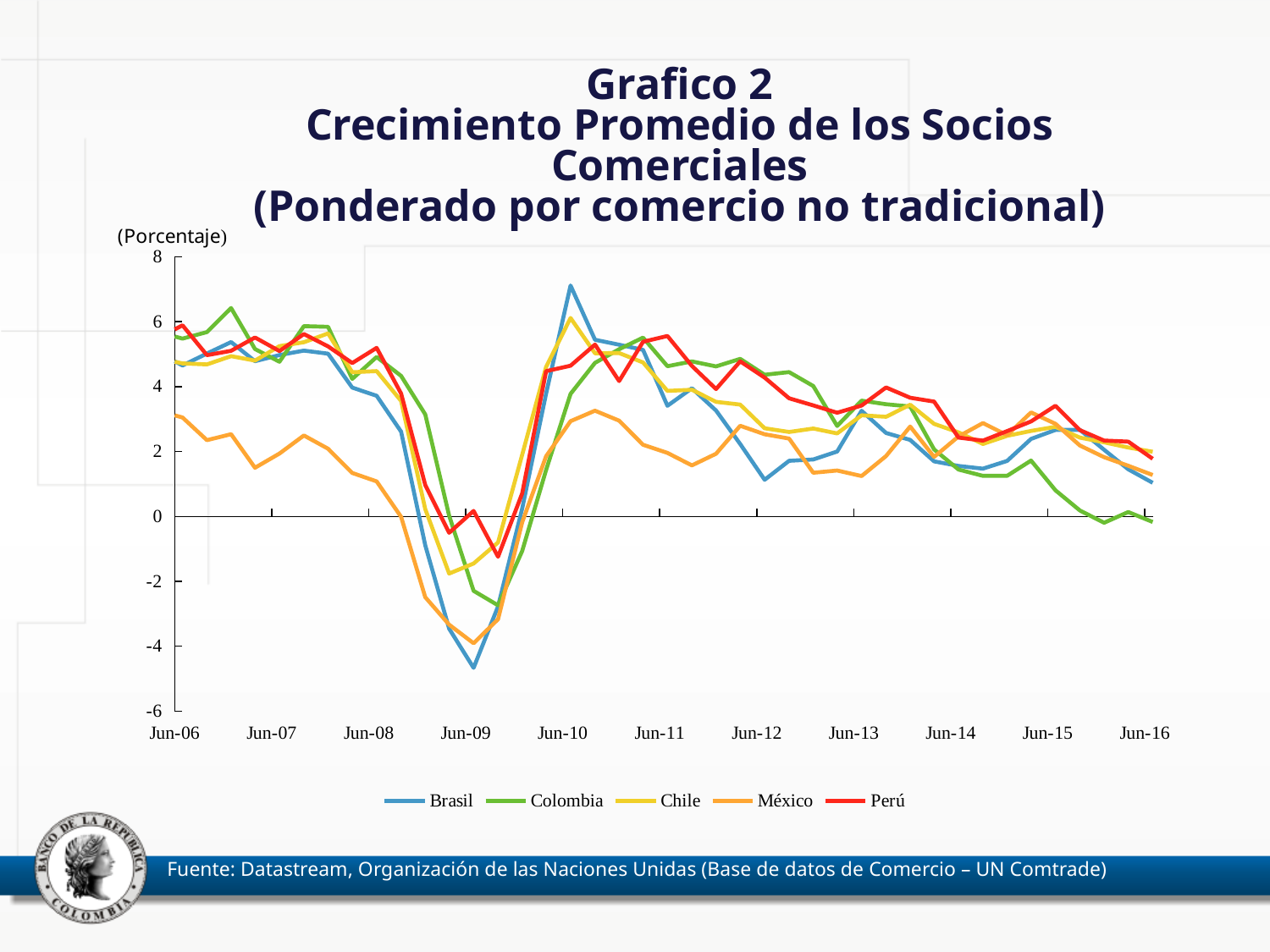
Which series reaches the highest peak around Jun-10? Brasil Is the peak value of the Brasil series around Jun-10 greater or less than 6? greater Does the Colombia series rise or fall between Jun-14 and Jun-16? Fall How many series does the legend list? 5 Is the value for México at Jun-06 greater or less than 4? less Is the lowest value of the Brasil series around Jun-09 greater or less than -4? less At Jun-06, which series has the higher value, Perú or México? Perú At Jun-16, which series has the higher value, Perú or Colombia? Perú Which series reaches the lowest value around Jun-09? Brasil What kind of chart is shown on the slide? Line chart What unit is indicated above the vertical axis of the chart? Porcentaje Which countries are listed in the chart legend? Brasil, Colombia, Chile, México, Perú